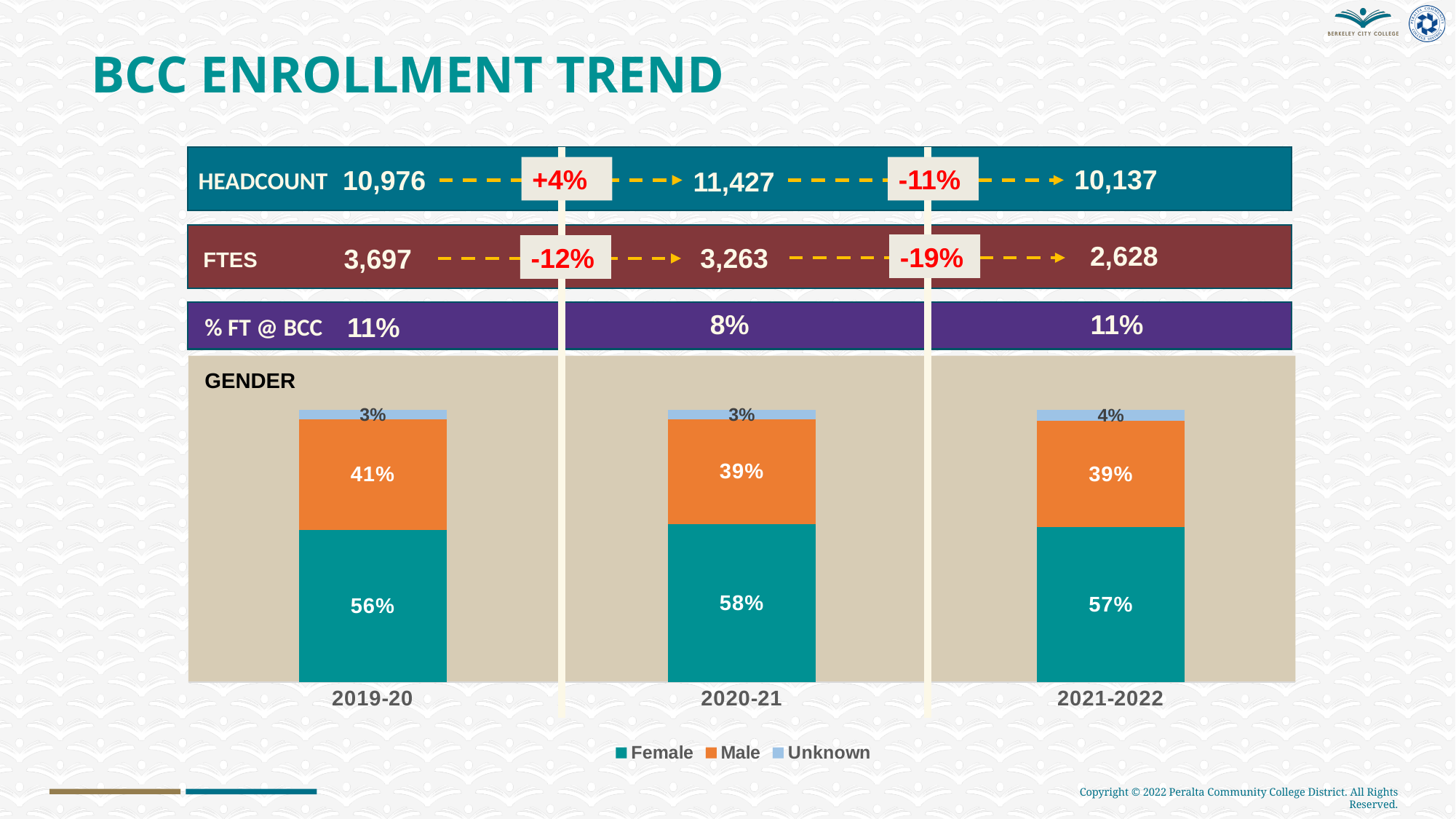
How many series does the legend of the Gender chart list? 3 In the Gender chart, which year has the highest Female percentage? 2020-21 In the Gender chart, is the Female percentage larger in 2020-21 or in 2021-2022? 2020-21 In the Gender chart, what percentage of students were Unknown gender in 2021-2022? 4% In the Gender chart, what percentage of students were Male in 2020-21? 39% In the Gender chart, which year has the highest Male percentage? 2019-20 In the Gender chart, what percentage of students were Female in 2019-20? 56% What kind of chart is the Gender chart? Stacked bar chart How many academic years are shown in the Gender chart? 3 In the Gender chart, what is the difference between the Female and Male percentages in 2019-20? 15 percentage points In the Gender chart, does the Female percentage rise or fall from 2019-20 to 2020-21? Rise What are the legend entries of the Gender chart? Female, Male, Unknown